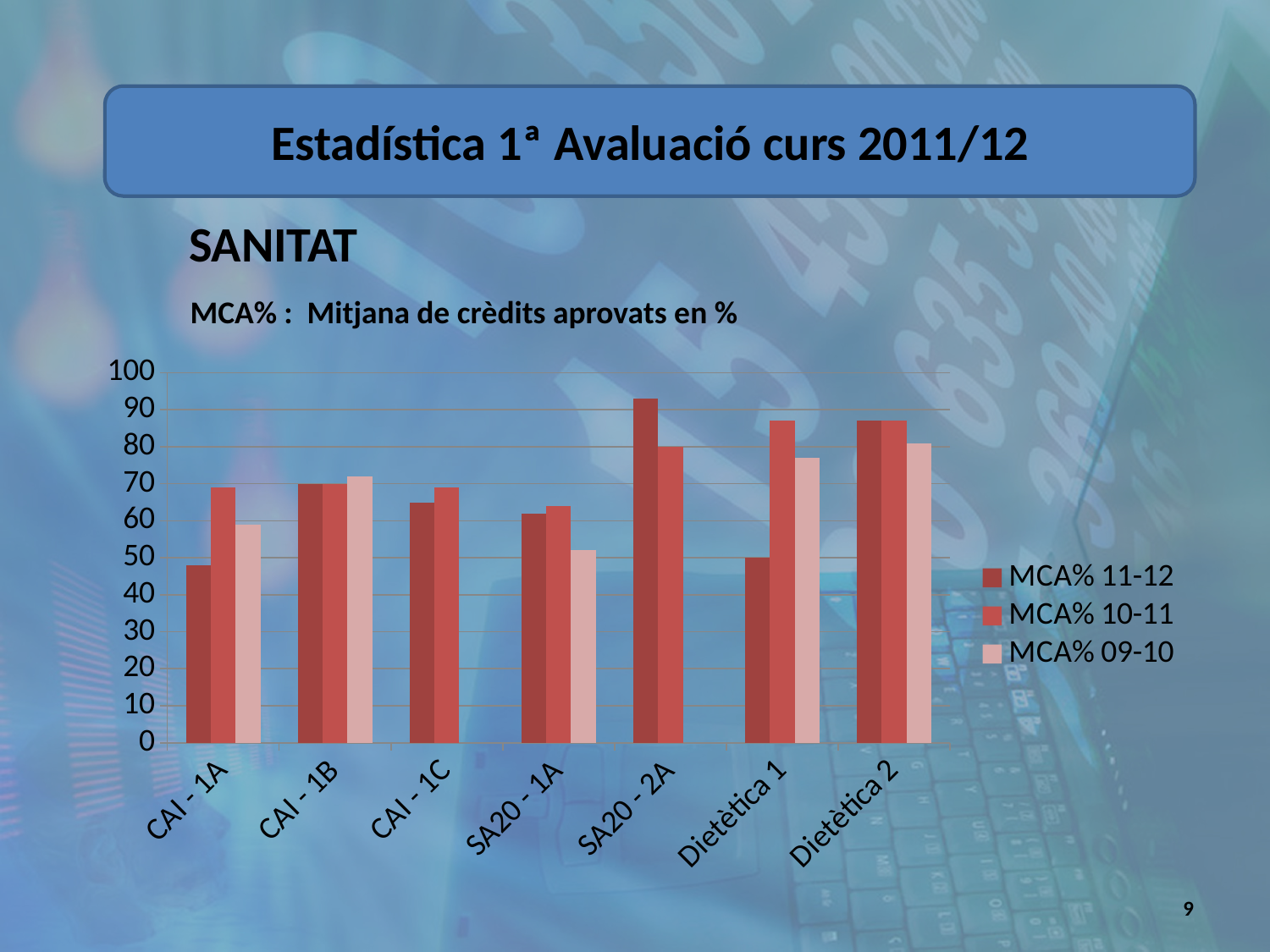
Which category has the lowest value for MCA% 09-10? SA20 - 1A What does the text above the chart say MCA% stands for? Mitjana de crèdits aprovats en % For Dietètica 1, which is larger: MCA% 11-12 or MCA% 10-11? MCA% 10-11 Is the MCA% 11-12 value for CAI - 1A greater or less than 50? less How many categories are shown on the x axis? 7 How many series does the legend list? 3 What kind of chart is shown on the slide? bar chart Which category has the highest value for MCA% 11-12? SA20 - 2A Is the MCA% 10-11 value for Dietètica 1 greater or less than 80? greater Which category has the highest value for MCA% 09-10? Dietètica 2 For SA20 - 2A, which is larger: MCA% 11-12 or MCA% 10-11? MCA% 11-12 Is the MCA% 11-12 value for SA20 - 2A greater or less than 90? greater